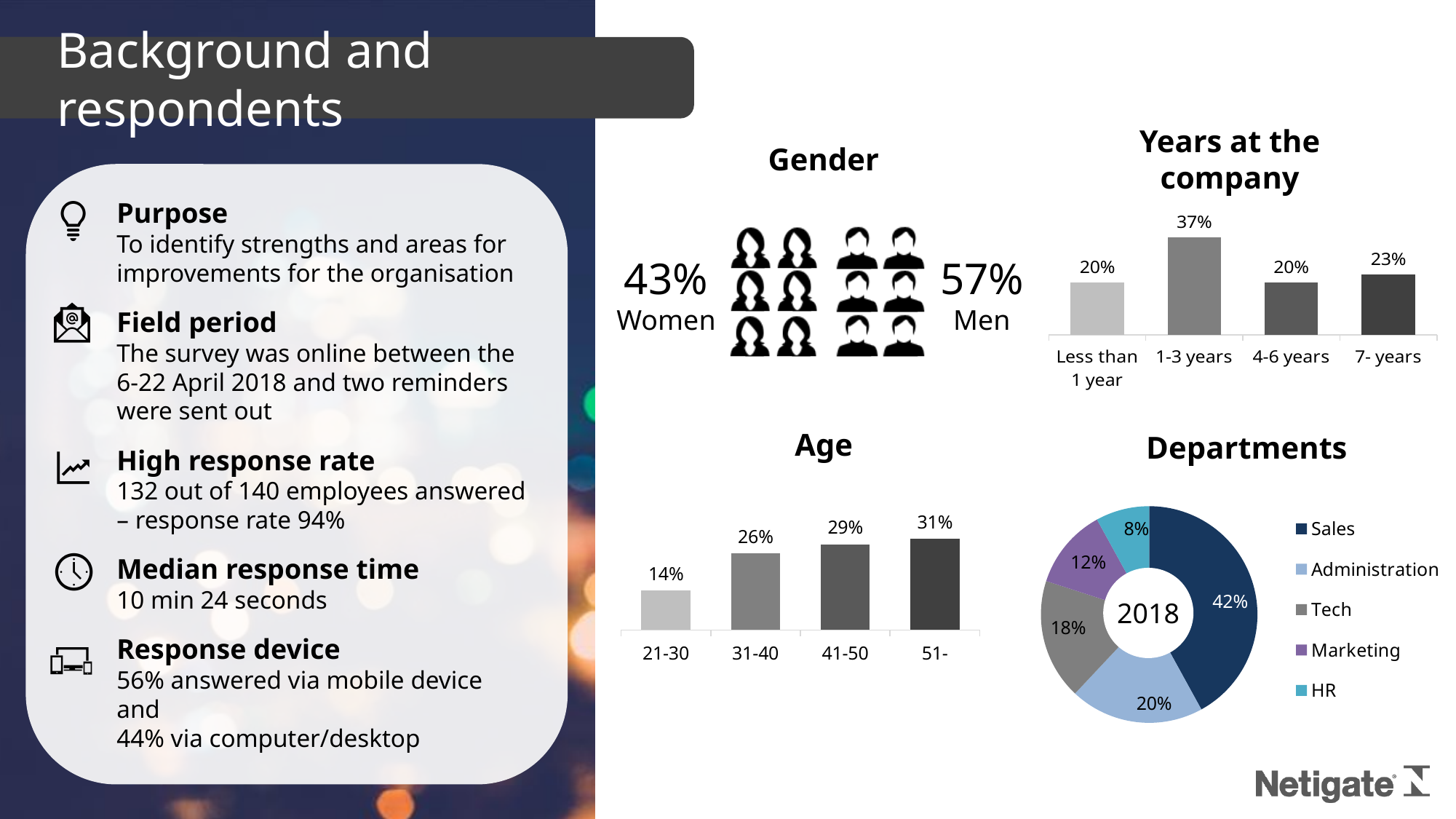
How many categories are shown in the 'Years at the company' chart? 4 In the 'Age' chart, do the values rise or fall from 21-30 to 51-? rise What kind of chart is the 'Age' chart? bar chart In the 'Years at the company' chart, which category has the highest value? 1-3 years In the 'Departments' chart, which department has the smallest share? HR In the 'Departments' chart, which is larger, Tech or Marketing? Tech How many entries does the legend of the 'Departments' chart list? 5 In the 'Age' chart, what is the value for 21-30? 14% In the 'Years at the company' chart, what is the value for 1-3 years? 37% In the 'Departments' chart, what share does Sales have? 42% In the 'Years at the company' chart, what is the difference between the values for 7- years and 4-6 years? 3% In the 'Age' chart, which age group has the lowest value? 21-30